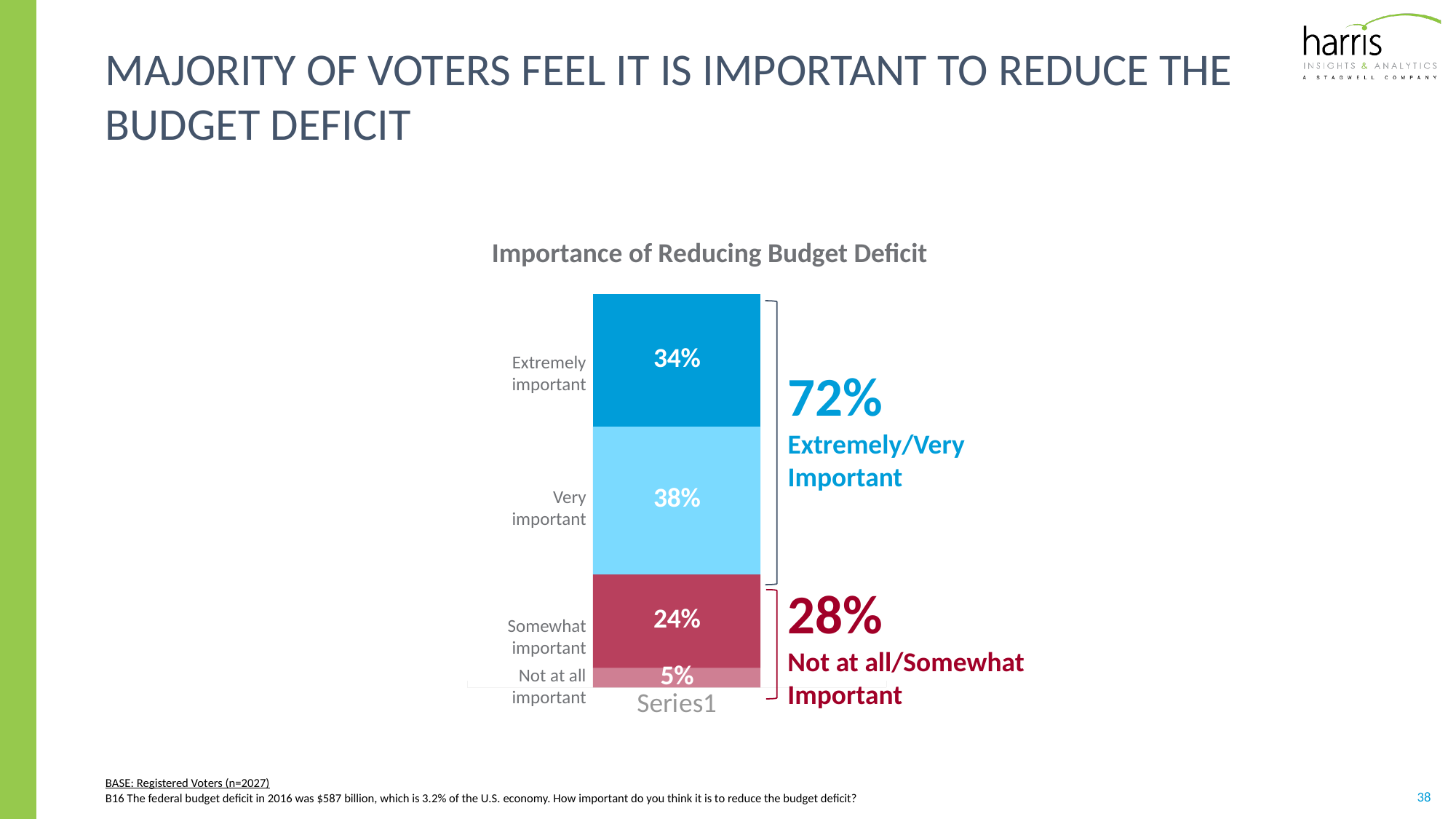
What is the difference between the 'Very important' and 'Extremely important' percentages? 4% What percentage of voters say reducing the budget deficit is extremely important? 34% How many response categories are shown in the stacked bar? 4 What percentage of voters say reducing the budget deficit is not at all important? 5% What is the combined percentage for Extremely/Very Important shown on the slide? 72% What percentage of voters say reducing the budget deficit is very important? 38% Which is larger, the share saying 'Somewhat important' or the share saying 'Extremely important'? Extremely important Which response category has the smallest share of voters? Not at all important Which response category has the largest share of voters? Very important What is the title of the chart? Importance of Reducing Budget Deficit What percentage of voters say reducing the budget deficit is somewhat important? 24% What is the combined percentage for Not at all/Somewhat Important shown on the slide? 28%